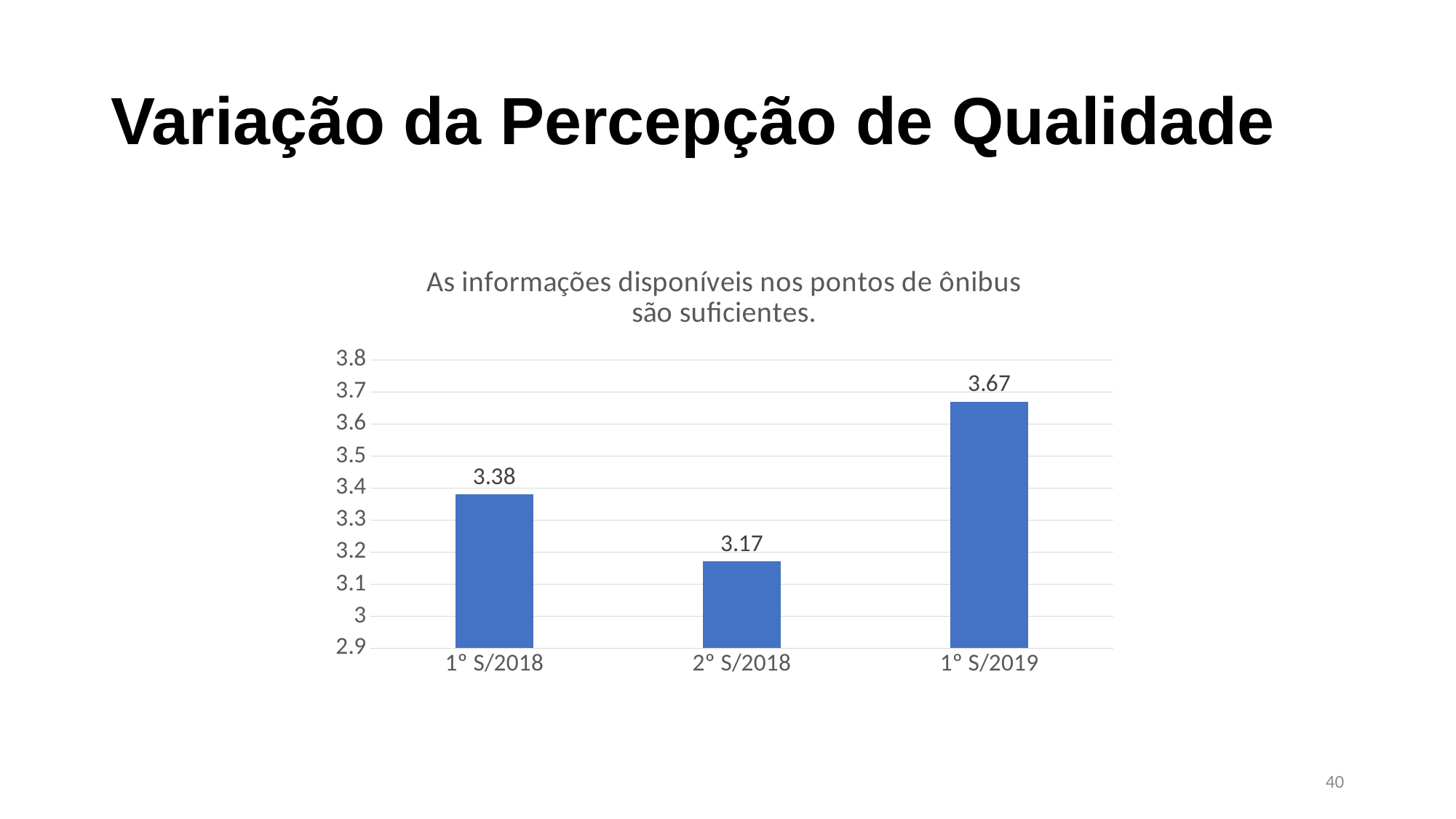
What is the difference between the values for 1° S/2018 and 2° S/2018? 0.21 Is the value for 2° S/2018 greater or less than 3.2? less How many periods are shown on the x axis? 3 What is the value for 2° S/2018? 3.17 What is the difference between the values for 1° S/2019 and 2° S/2018? 0.5 Which is larger, the value for 1° S/2018 or the value for 1° S/2019? 1° S/2019 Which period has the lowest value? 2° S/2018 What is the title of the chart? As informações disponíveis nos pontos de ônibus são suficientes. What kind of chart is shown on the slide? bar chart What is the value for 1° S/2019? 3.67 What is the value for 1° S/2018? 3.38 Which period has the highest value? 1° S/2019